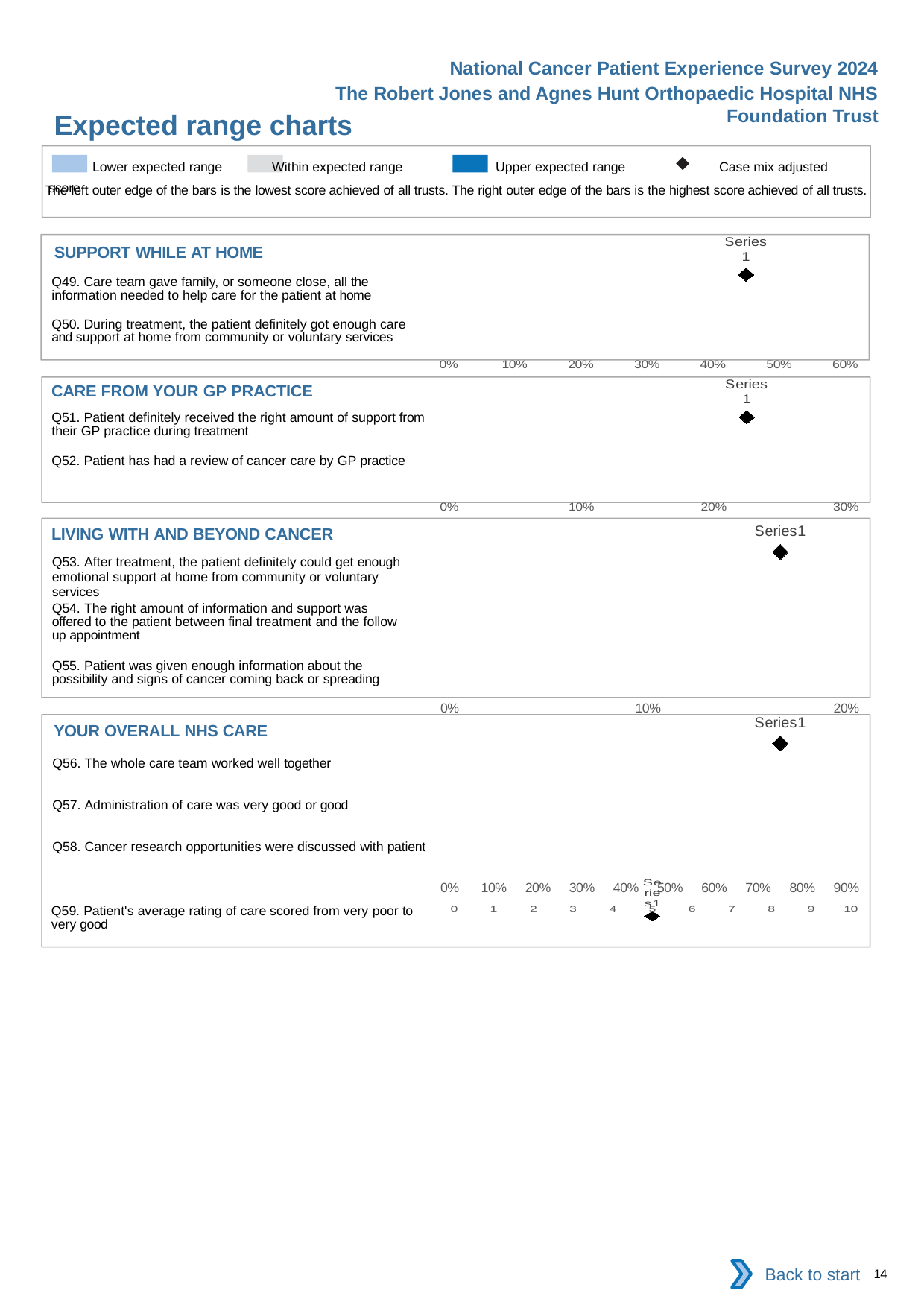
What is the highest percentage tick shown on the x axis of the SUPPORT WHILE AT HOME chart? 60% In the YOUR OVERALL NHS CARE chart, is the Series1 marker greater or less than 70%? greater What is the title of the slide containing these charts? Expected range charts In the CARE FROM YOUR GP PRACTICE chart, is the Series 1 marker greater or less than 20%? greater In the SUPPORT WHILE AT HOME chart, is the Series 1 marker greater or less than 50%? less How many entries does the legend at the top of the slide list? 4 How many questions are listed in the YOUR OVERALL NHS CARE chart? 4 How many questions are listed in the LIVING WITH AND BEYOND CANCER chart? 3 How many questions are listed in the SUPPORT WHILE AT HOME chart? 2